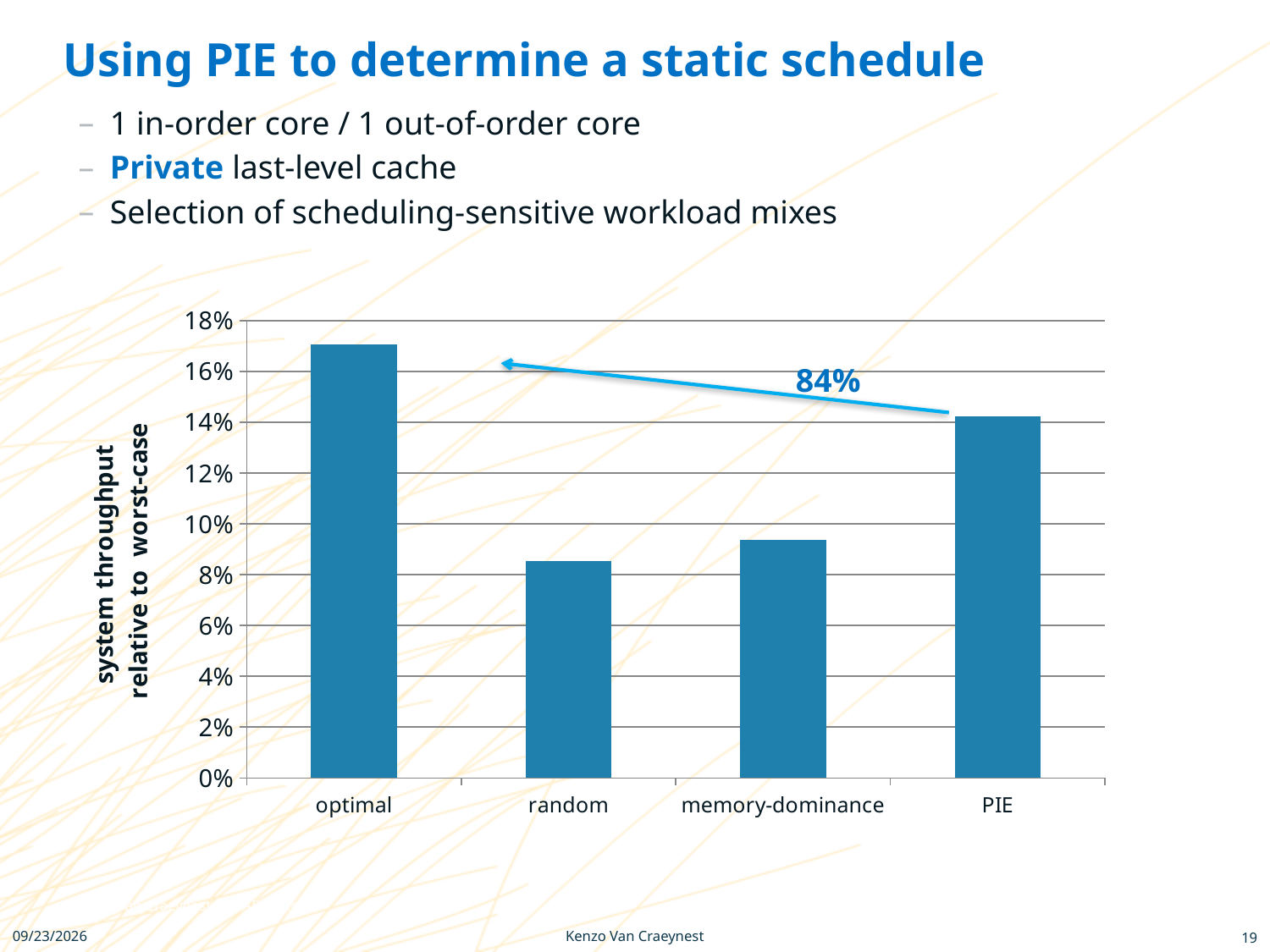
Is the value for memory-dominance greater or less than 10%? less What is the label on the y axis of the chart? system throughput relative to worst-case Which is larger, the value for PIE or the value for memory-dominance? PIE Is the value for random greater or less than 10%? less Is the value for optimal greater or less than 16%? greater Which category has the lowest system throughput relative to worst-case? random Which category has the highest system throughput relative to worst-case? optimal How many categories are shown on the x axis of the chart? 4 What kind of chart is shown on the slide? bar chart What percentage is written on the arrow annotation between the PIE bar and the optimal bar? 84% Which is larger, the value for optimal or the value for PIE? optimal